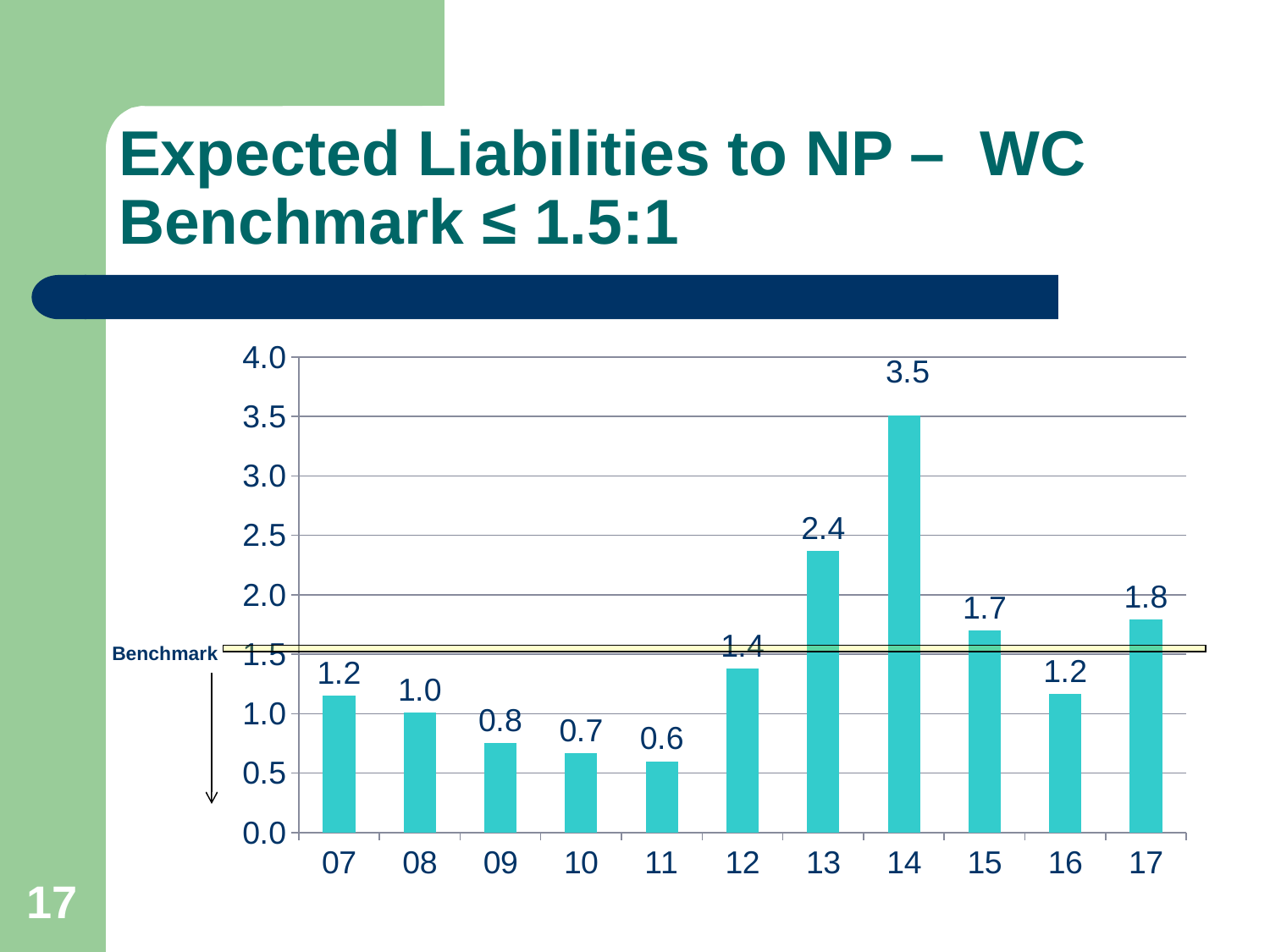
Is the value for 13 greater or less than 2.0? greater How many years are shown on the x axis? 11 Do the values rise or fall from 07 to 11? fall Which year has the lowest value? 11 Which is larger, the value for 15 or the value for 16? 15 What is the value for 11? 0.6 What kind of chart is this? bar chart What is the difference between the values for 14 and 13? 1.1 Which year has the highest value? 14 What is the value for 14? 3.5 What is the value for 17? 1.8 What benchmark value is marked by the horizontal line on the chart? 1.5